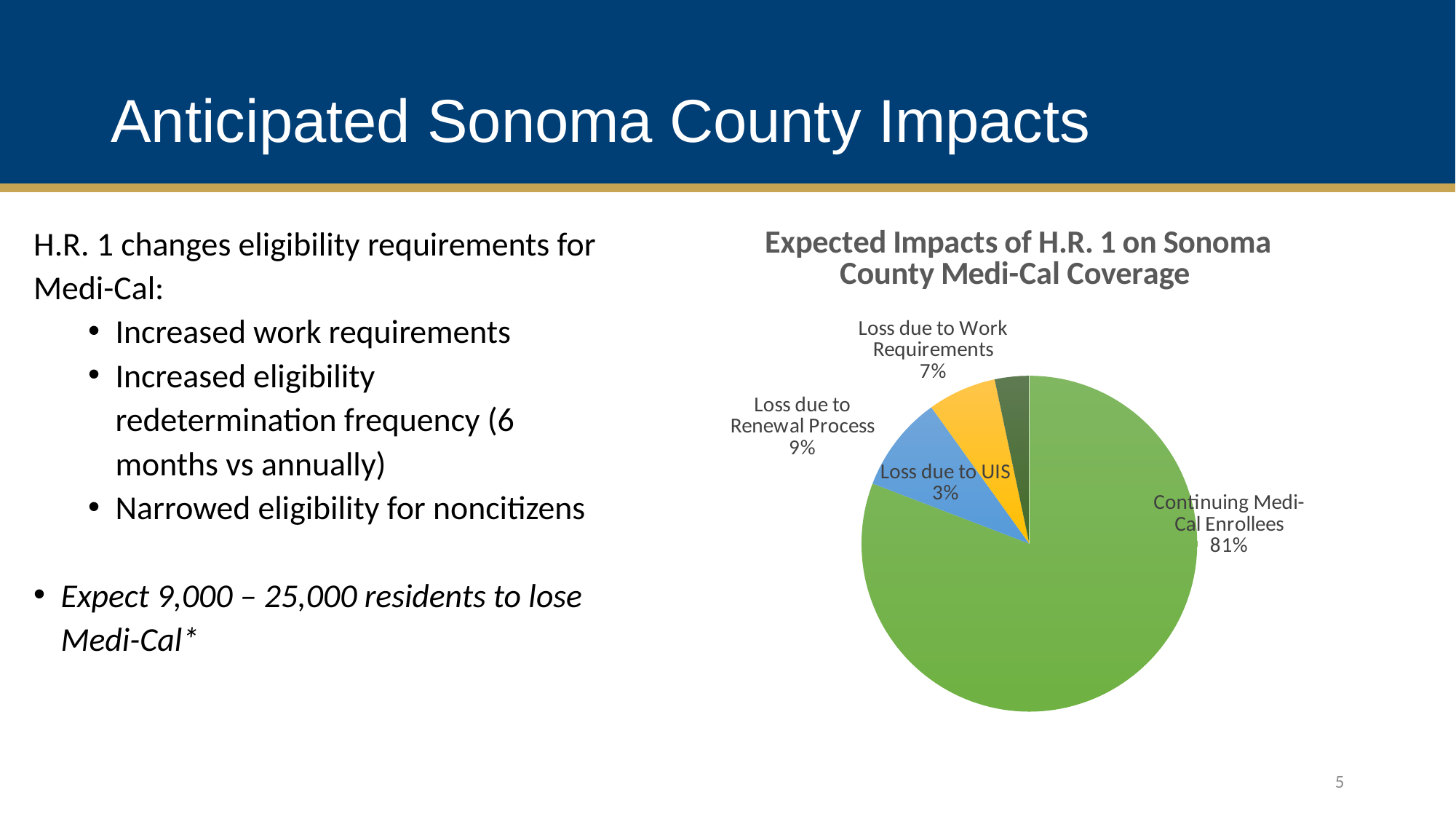
What share of the pie is Continuing Medi-Cal Enrollees? 81% Which is larger: Loss due to Renewal Process or Loss due to Work Requirements? Loss due to Renewal Process What colour is the Continuing Medi-Cal Enrollees slice? Green How many slices does the pie chart have? 4 Which slice of the pie is the smallest? Loss due to UIS What share of the pie is Loss due to Work Requirements? 7% What is the title of the chart? Expected Impacts of H.R. 1 on Sonoma County Medi-Cal Coverage What share of the pie is Loss due to Renewal Process? 9% Which slice of the pie is the largest? Continuing Medi-Cal Enrollees What kind of chart is shown on the slide? Pie chart What is the difference between the Loss due to Renewal Process share and the Loss due to UIS share? 6%